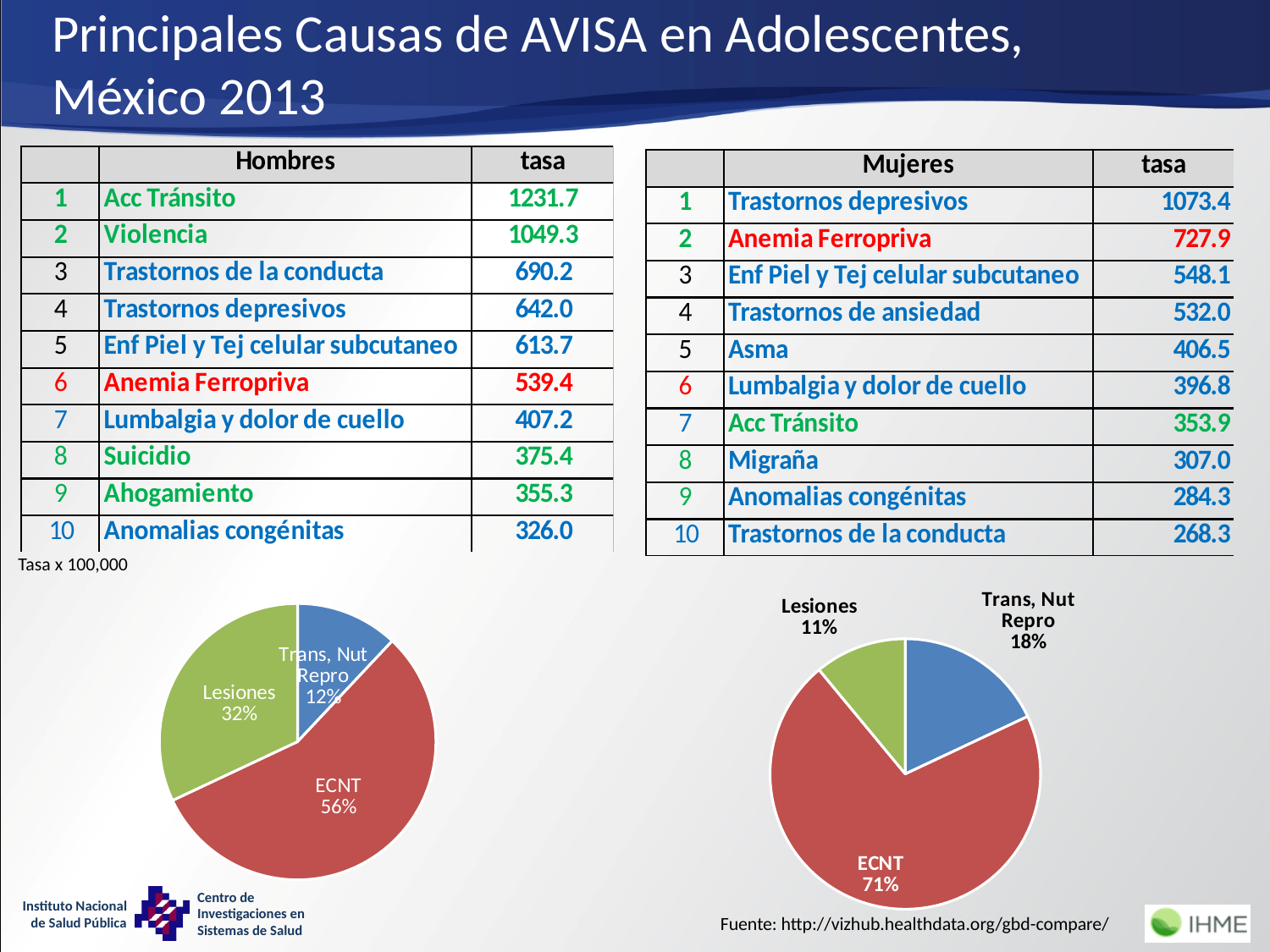
What kind of chart is shown on the right of the slide below the Mujeres table? Pie chart In the pie chart on the right of the slide, what share does Trans, Nut Repro have? 18% Which is larger: the Lesiones share in the left pie chart or the Lesiones share in the right pie chart? Left pie chart In the pie chart on the right of the slide, what share does Lesiones have? 11% In the pie chart on the right of the slide, what share does ECNT have? 71% In the pie chart on the left of the slide, how many slices are there? 3 In the pie chart on the right of the slide, what is the difference between the ECNT share and the Lesiones share? 60% In the pie chart on the right of the slide, which slice is the smallest? Lesiones In the pie chart on the left of the slide, which slice is the largest? ECNT